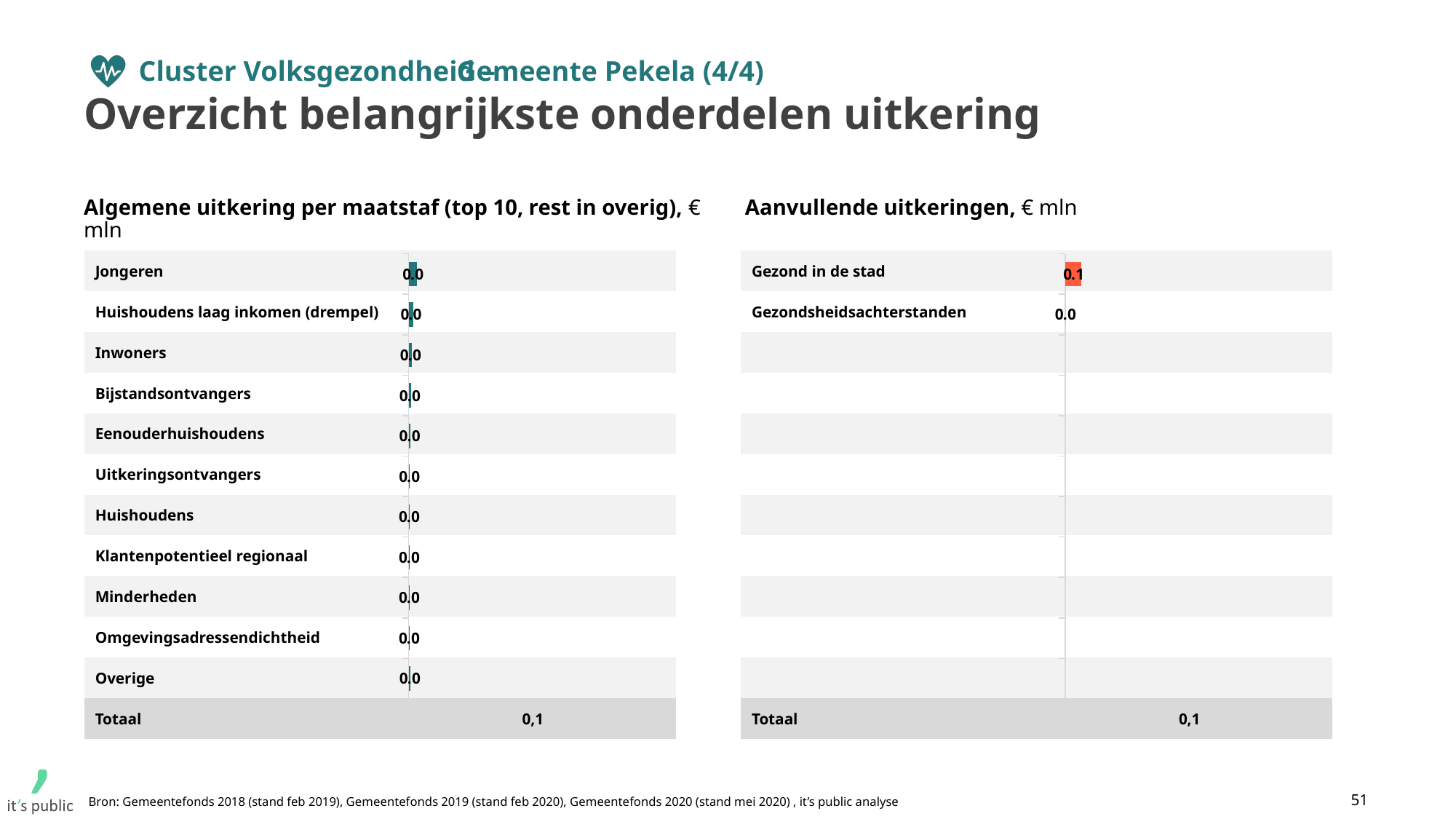
In the chart 'Algemene uitkering per maatstaf', what is the value for Huishoudens laag inkomen (drempel)? 0.0 In the chart 'Aanvullende uitkeringen', how many categories are plotted? 2 What kind of chart is the left chart 'Algemene uitkering per maatstaf'? Bar chart In the chart 'Aanvullende uitkeringen', what is the Totaal value shown? 0,1 In the chart 'Aanvullende uitkeringen', which is larger: Gezond in de stad or Gezondsheidsachterstanden? Gezond in de stad In the chart 'Algemene uitkering per maatstaf', what is the value for Jongeren? 0.0 In the chart 'Algemene uitkering per maatstaf', what is the Totaal value shown? 0,1 In the chart 'Aanvullende uitkeringen', what is the value for Gezondsheidsachterstanden? 0.0 In the chart 'Algemene uitkering per maatstaf', how many categories are plotted (including Overige)? 11 What unit is stated in the title of the right chart 'Aanvullende uitkeringen'? € mln In the chart 'Aanvullende uitkeringen', what is the value for Gezond in de stad? 0.1 In the chart 'Aanvullende uitkeringen', which category has the highest value? Gezond in de stad